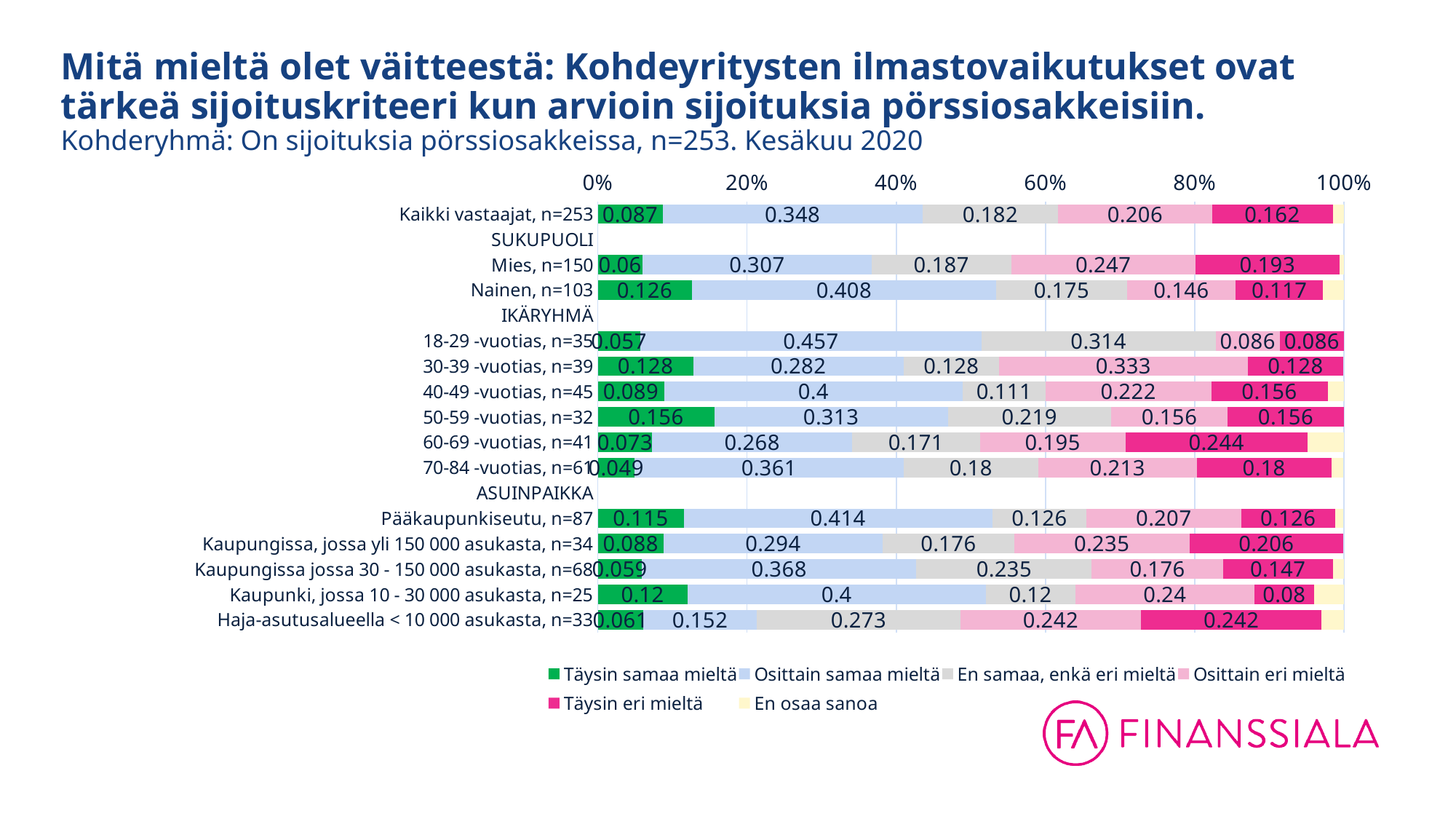
What is the difference between the 'Täysin samaa mieltä' values for 'Nainen, n=103' and 'Mies, n=150'? 0.066 What is the value of 'En samaa, enkä eri mieltä' for '18-29 -vuotias, n=35'? 0.314 What kind of chart is shown on the slide? Stacked bar chart What is the value of 'Osittain eri mieltä' for 'Kaupunki, jossa 10 - 30 000 asukasta, n=25'? 0.24 Which age group has the highest value for 'Osittain samaa mieltä'? 18-29 -vuotias, n=35 Which has the larger 'Täysin eri mieltä' value, 'Mies, n=150' or 'Nainen, n=103'? Mies, n=150 What is the value of 'Täysin samaa mieltä' for 'Nainen, n=103'? 0.126 What is the value of 'Osittain samaa mieltä' for 'Kaikki vastaajat, n=253'? 0.348 How many age groups (IKÄRYHMÄ) are shown in the chart? 6 How many series does the legend list? 6 Which age group has the highest value for 'Täysin samaa mieltä'? 50-59 -vuotias, n=32 What is the value of 'Täysin eri mieltä' for 'Mies, n=150'? 0.193